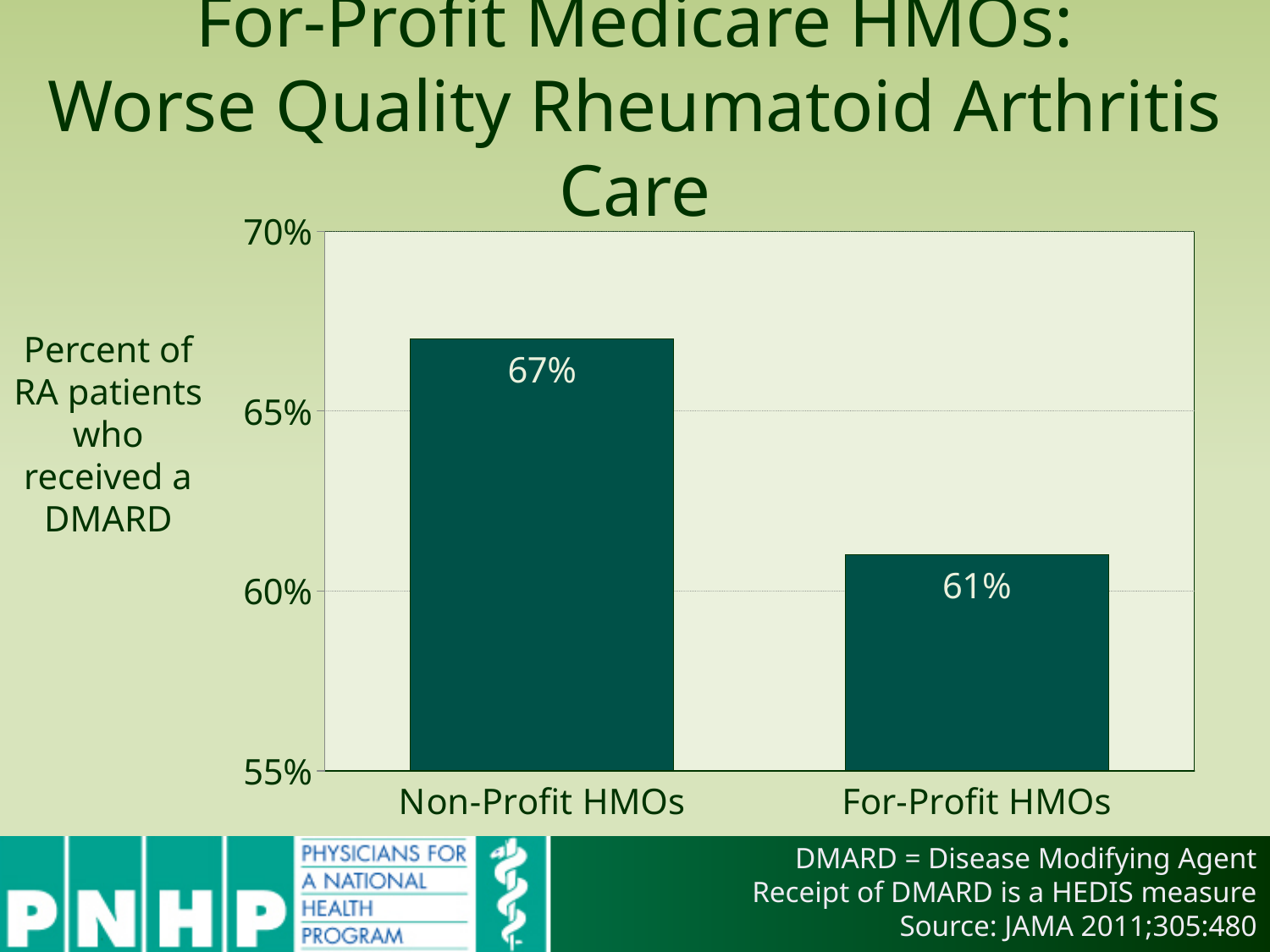
Is the value for Non-Profit HMOs greater or less than 65%? greater What is the difference in percentage points between Non-Profit HMOs and For-Profit HMOs? 6 What kind of chart is shown on the slide? bar chart What is the title of the slide? For-Profit Medicare HMOs: Worse Quality Rheumatoid Arthritis Care How many categories are shown on the chart? 2 What percent of RA patients received a DMARD in For-Profit HMOs? 61% Which category has the lower percentage of RA patients who received a DMARD? For-Profit HMOs Which category has the higher percentage of RA patients who received a DMARD? Non-Profit HMOs Is the value for Non-Profit HMOs larger or smaller than the value for For-Profit HMOs? larger What does the vertical axis label say the chart measures? Percent of RA patients who received a DMARD Is the value for For-Profit HMOs greater or less than 65%? less What percent of RA patients received a DMARD in Non-Profit HMOs? 67%